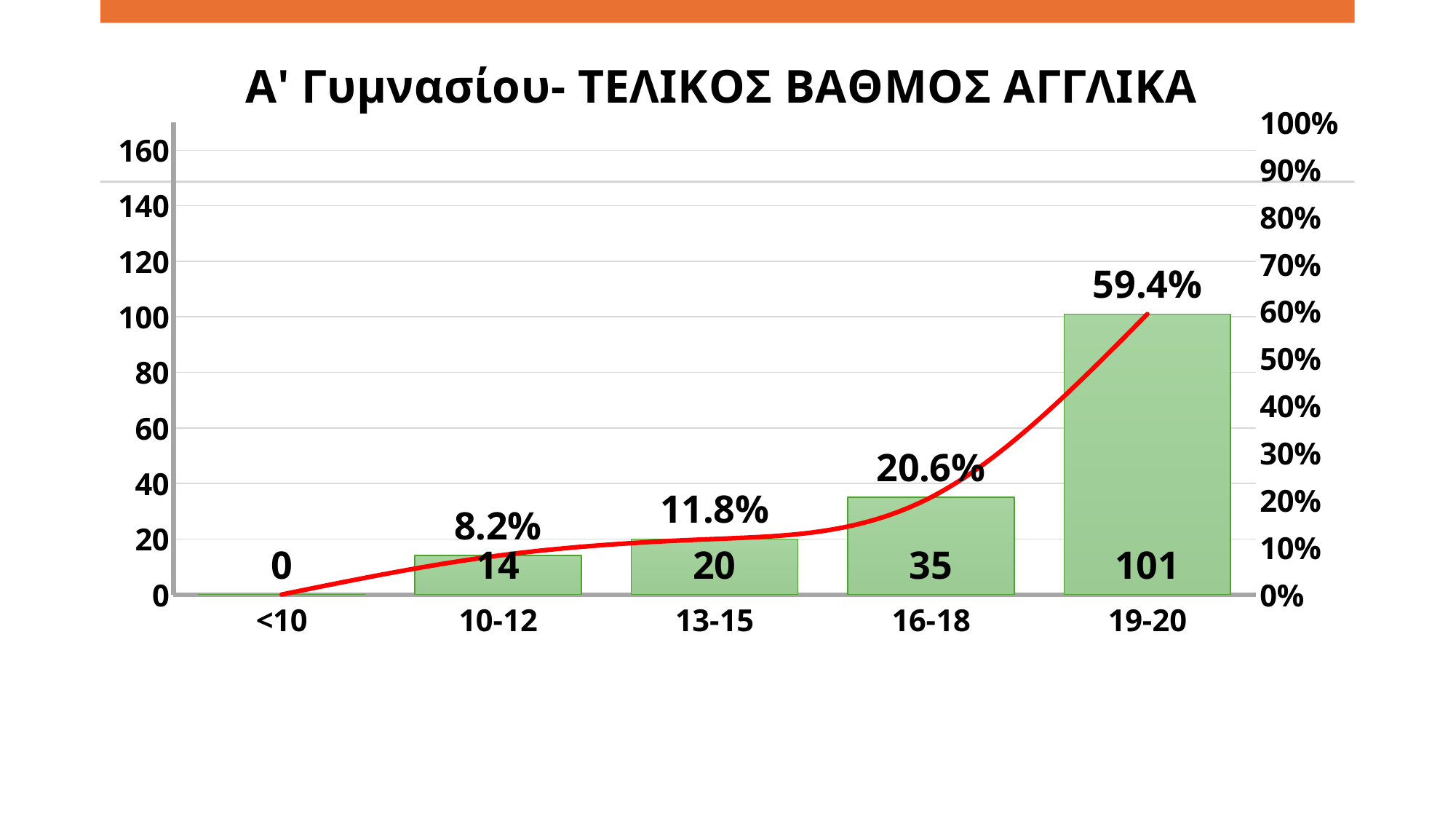
What percentage is shown on the line for the 13-15 grade band? 11.8% What percentage is shown on the line for the 10-12 grade band? 8.2% How many grade bands are shown on the x axis? 5 Which grade band has the lowest bar? <10 What is the number of students in the 16-18 grade band? 35 What is the total of all the bar values shown? 170 Which grade band has the highest bar? 19-20 What is the number of students in the 19-20 grade band? 101 Which is larger, the bar value for 13-15 or for 10-12? 13-15 What is the title of the chart? Α' Γυμνασίου- ΤΕΛΙΚΟΣ ΒΑΘΜΟΣ ΑΓΓΛΙΚΑ What is the difference between the bar values for 19-20 and 16-18? 66 Do the bar values rise or fall from left to right along the x axis? rise